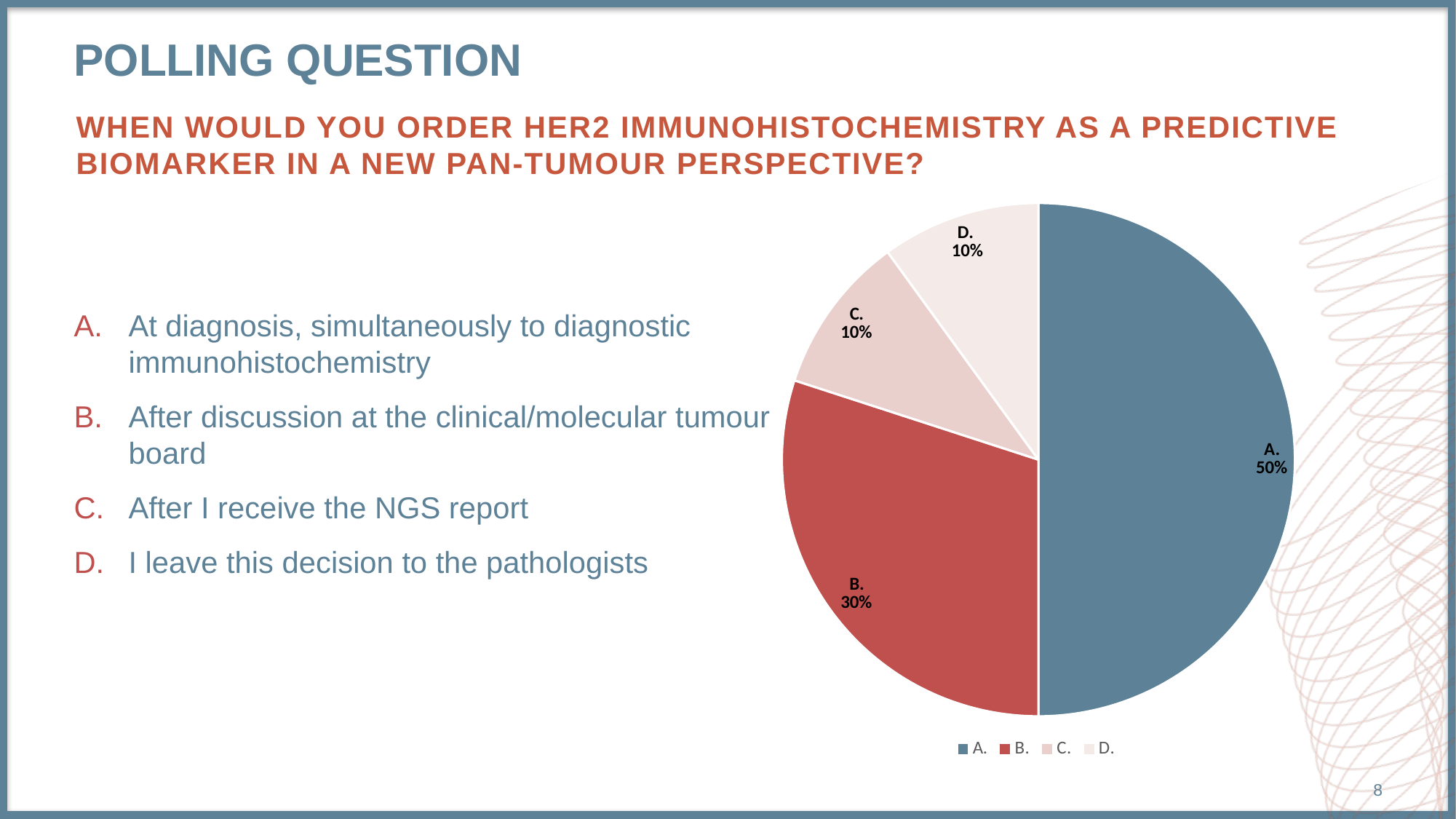
What is the difference in percentage points between option A. and option B.? 20 What share of the pie does option A. have? 50% What share of the pie does option C. have? 10% What colour is the slice for option B.? red What share of the pie does option B. have? 30% How many slices does the pie chart have? 4 What is the combined share of options C. and D.? 20% What kind of chart is shown on the slide? pie chart Which is larger, the slice for option B. or the slice for option C.? B. How many entries does the legend list? 4 Which option has the largest slice of the pie? A. What share of the pie does option D. have? 10%